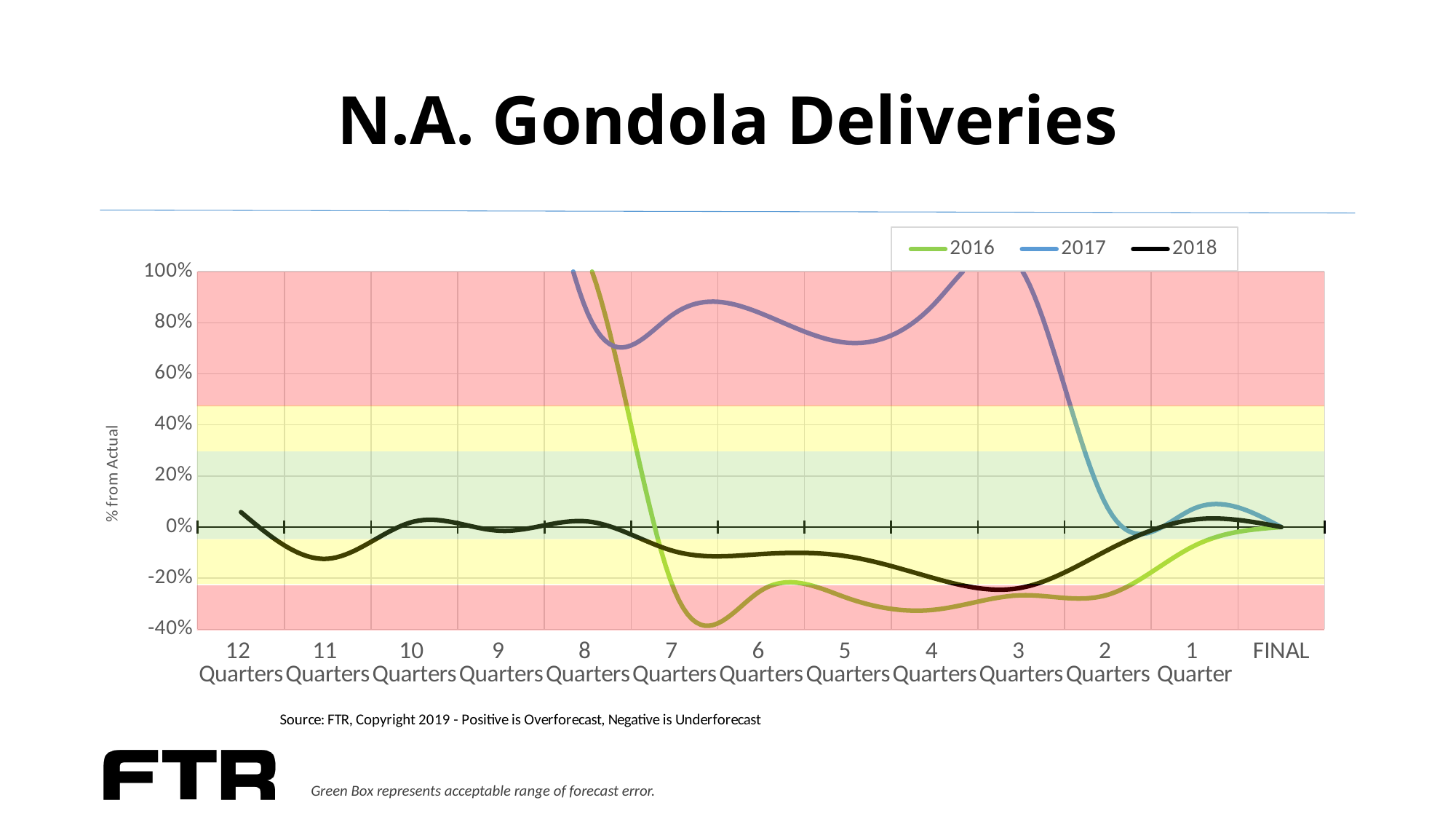
How many series does the legend list? 3 At 4 Quarters, which series has the larger value, 2016 or 2018? 2018 What kind of chart is shown on the slide? line chart Is the value for 2016 at 4 Quarters greater or less than -20%? less How many categories are shown along the x axis? 13 What is the title of the y axis? % from Actual Is the value for 2017 at 6 Quarters greater or less than 80%? greater Does the 2017 series rise or fall between 3 Quarters and 2 Quarters? fall Is the value for 2018 at 11 Quarters greater or less than 0%? less At 6 Quarters, which series has the larger value, 2016 or 2017? 2017 What is the value of the 2018 series at FINAL? 0%